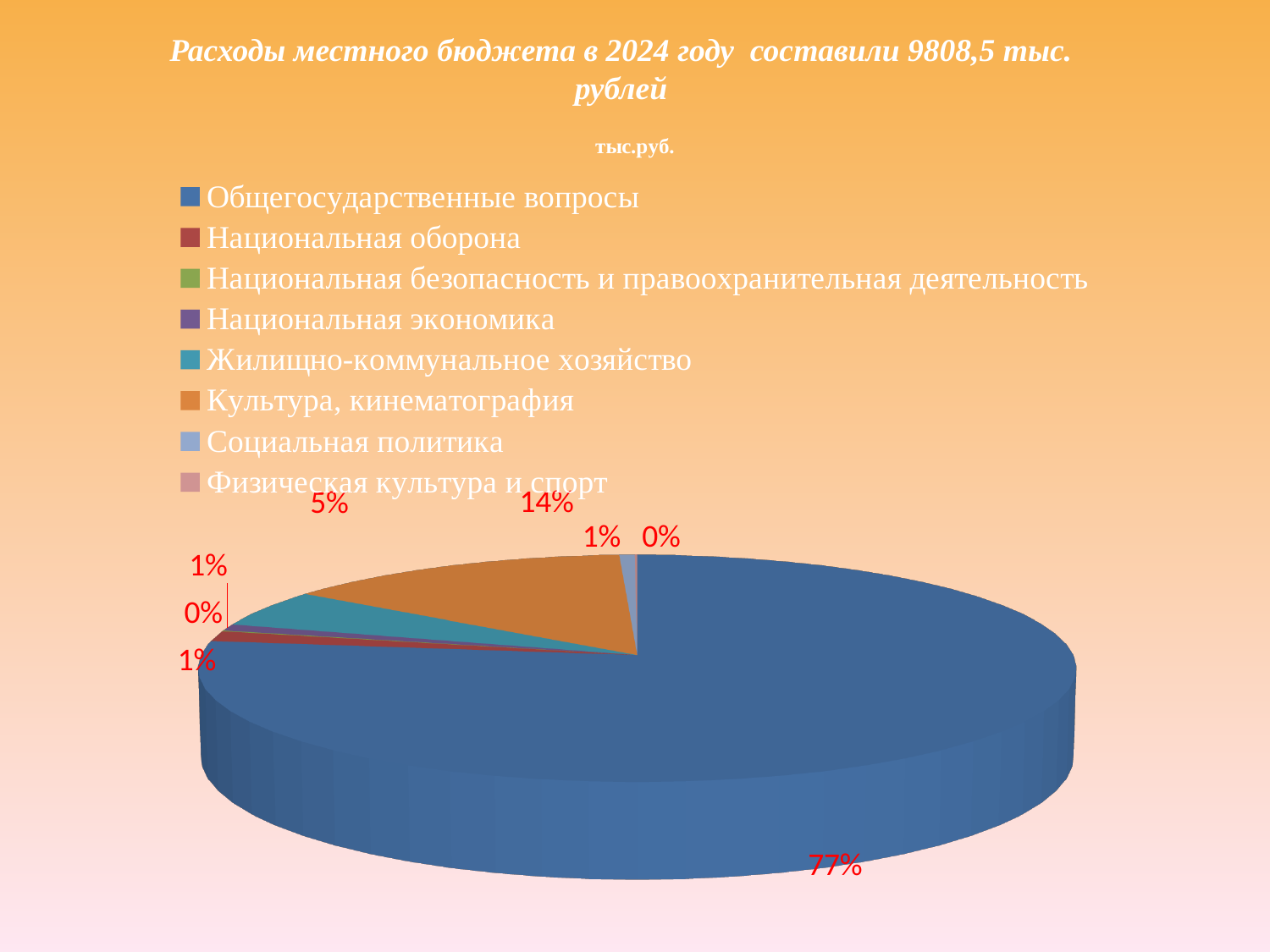
What unit label is shown above the pie chart's legend? тыс.руб. Is the share for Общегосударственные вопросы greater or less than 50%? greater How many categories does the legend of the pie chart list? 8 What share of the pie does Общегосударственные вопросы account for? 77% What kind of chart is shown on the slide? Pie chart By how many percentage points does the share of Общегосударственные вопросы exceed the share of Культура, кинематография? 63 percentage points What total amount of local budget expenditure in 2024 is stated in the slide title? 9808,5 тыс. рублей What share of the pie does Культура, кинематография account for? 14% Which is larger: the share for Культура, кинематография or the share for Жилищно-коммунальное хозяйство? Культура, кинематография What share of the pie does Жилищно-коммунальное хозяйство account for? 5% Which category has the largest share of the pie chart? Общегосударственные вопросы